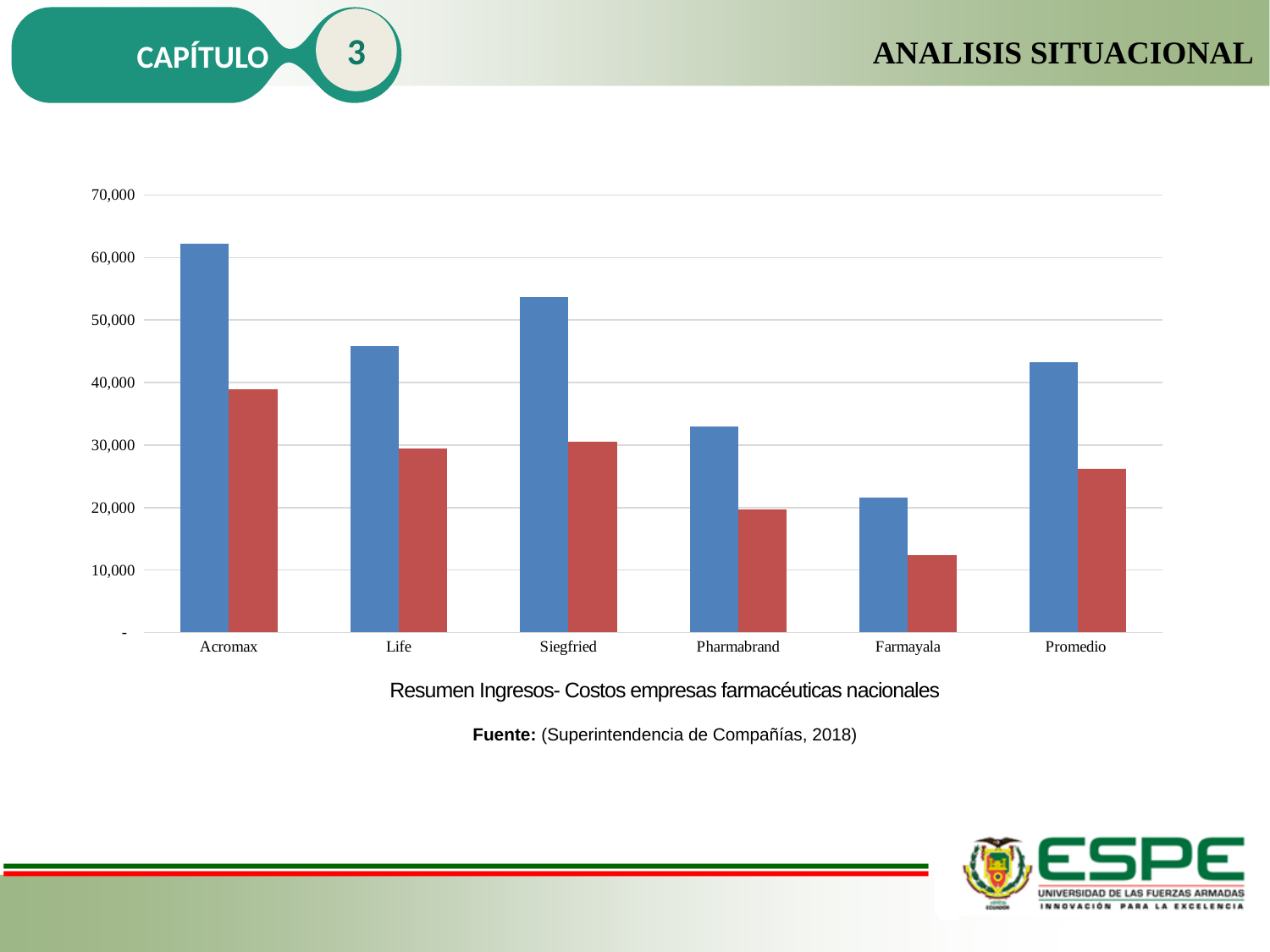
How many categories are shown along the x axis of the chart? 6 Which category has the tallest red bar? Acromax Is the red bar for Promedio greater or less than 30,000? less Is the red bar for Farmayala greater or less than 10,000? greater Which category has the tallest blue bar? Acromax Which category has the shortest blue bar? Farmayala What kind of chart is shown on the slide? Bar chart Which has the larger blue bar, Life or Siegfried? Siegfried Is the blue bar for Acromax greater or less than 60,000? greater What is the caption printed below the chart? Resumen Ingresos- Costos empresas farmacéuticas nacionales Which category has the shortest red bar? Farmayala